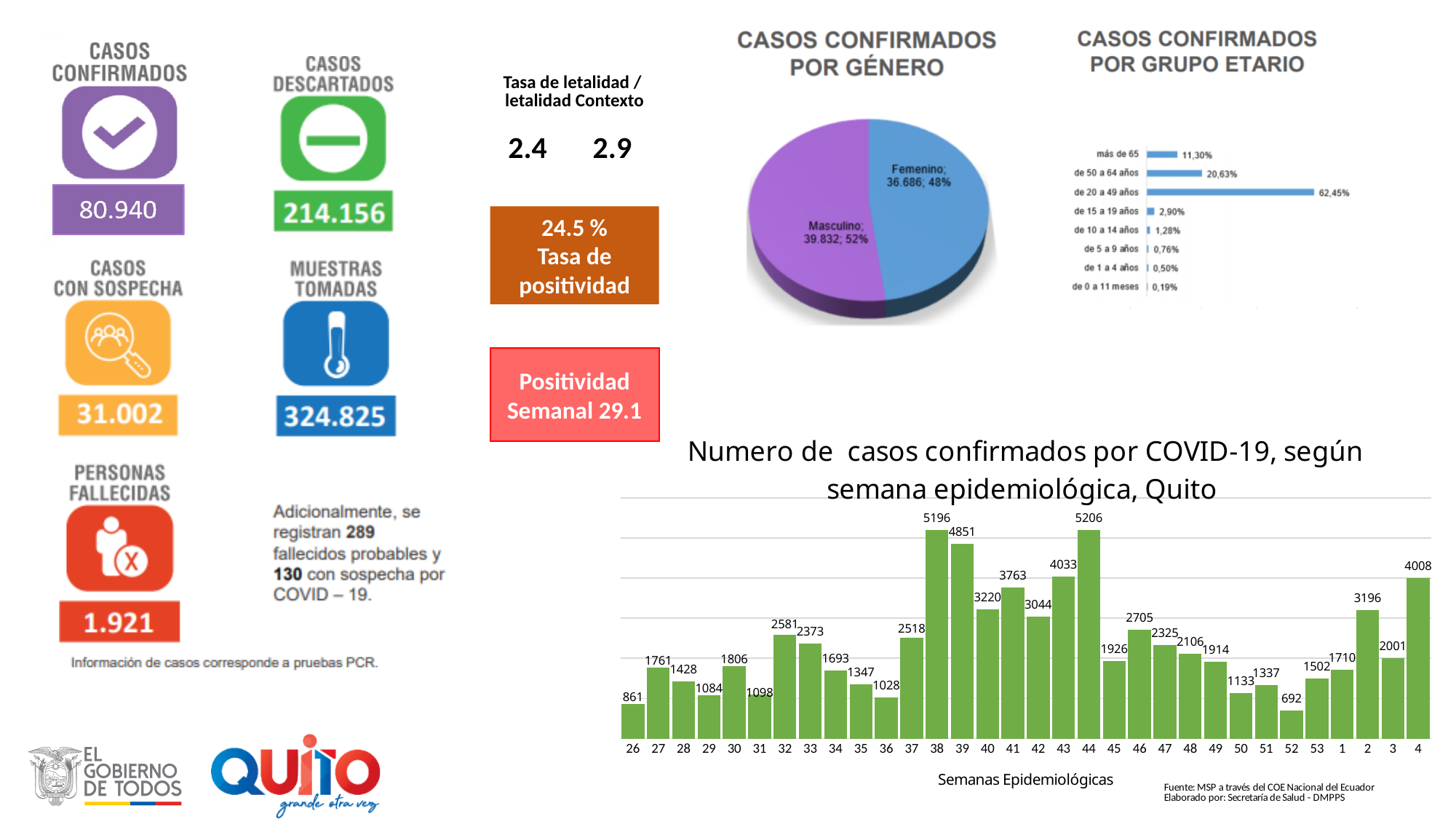
What type of chart is 'Numero de casos confirmados por COVID-19, según semana epidemiológica, Quito'? Bar chart In the 'CASOS CONFIRMADOS POR GRUPO ETARIO' chart, what is the percentage for 'de 50 a 64 años'? 20,63% In the chart 'Numero de casos confirmados por COVID-19, según semana epidemiológica, Quito', how many confirmed cases were there in week 38? 5196 In the 'CASOS CONFIRMADOS POR GÉNERO' pie chart, what share of confirmed cases is Masculino? 52% In the 'CASOS CONFIRMADOS POR GÉNERO' pie chart, how many confirmed cases are Femenino? 36.686 In the 'CASOS CONFIRMADOS POR GÉNERO' pie chart, which gender has the larger share of confirmed cases? Masculino In the chart 'Numero de casos confirmados por COVID-19, según semana epidemiológica, Quito', which week has the highest number of confirmed cases? 44 In the 'CASOS CONFIRMADOS POR GRUPO ETARIO' chart, how many age groups are shown? 8 In the chart 'Numero de casos confirmados por COVID-19, según semana epidemiológica, Quito', what is the difference in confirmed cases between week 38 and week 39? 345 In the chart 'Numero de casos confirmados por COVID-19, según semana epidemiológica, Quito', which week has the lowest number of confirmed cases? 52 In the 'CASOS CONFIRMADOS POR GRUPO ETARIO' chart, which age group has the lowest percentage? de 0 a 11 meses In the 'CASOS CONFIRMADOS POR GRUPO ETARIO' chart, which age group has the highest percentage of confirmed cases? de 20 a 49 años